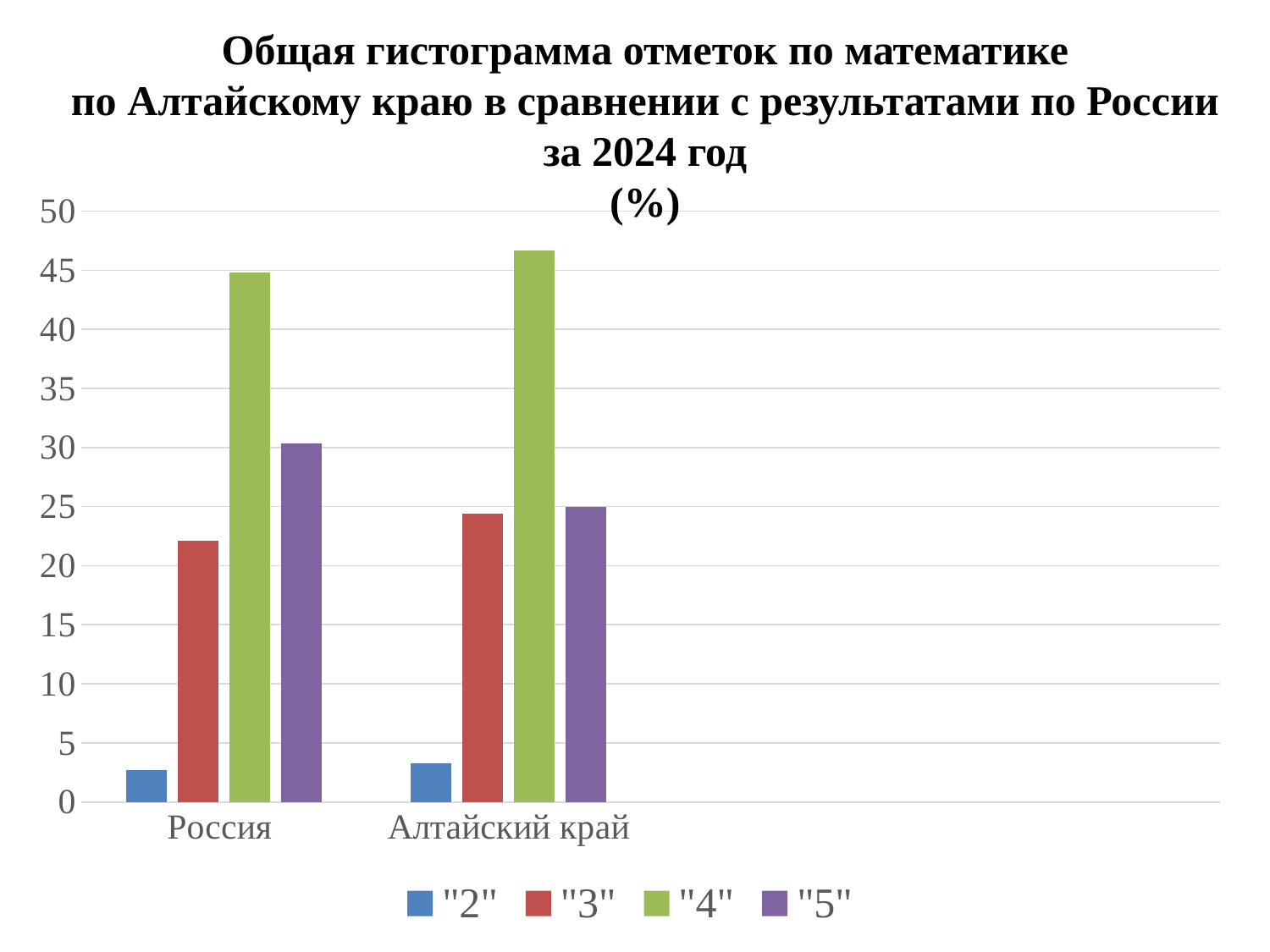
How many series does the legend list? 4 Is the value for "2" in Россия greater or less than 5? less Which grade has the highest value for Россия? "4" Which is larger, the value for "4" in Россия or in Алтайский край? Алтайский край Is the value for "5" in Россия greater or less than 25? greater Is the value for "4" in Россия greater or less than 40? greater What kind of chart is shown on the slide? bar chart How many categories are shown on the x axis? 2 Which grade has the lowest value for Алтайский край? "2" What colour are the bars for the "4" series? green Which is larger, the value for "5" in Россия or in Алтайский край? Россия